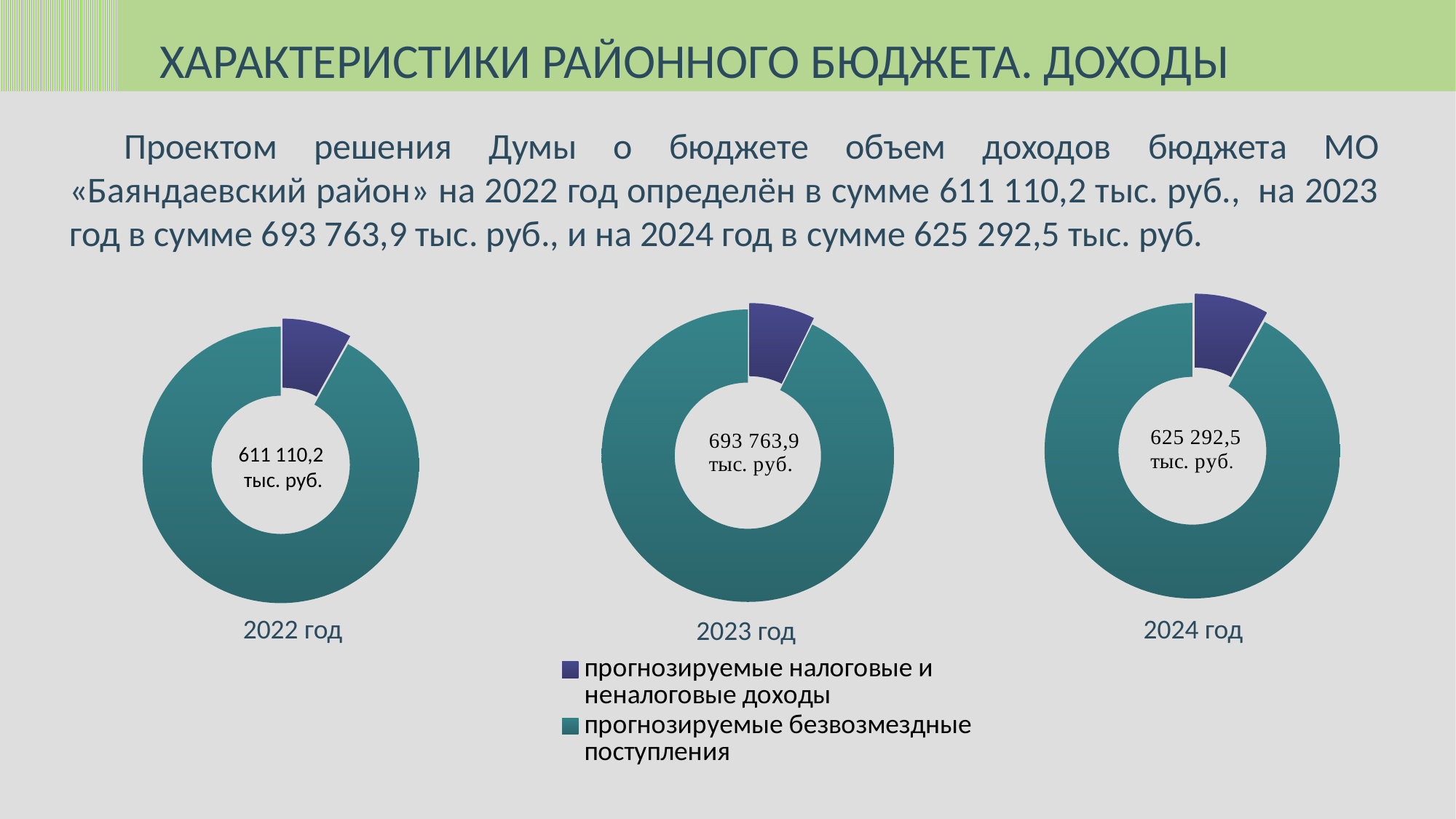
How many charts are shown on the slide? 3 In the 2022 год chart, what total value is printed in the centre? 611 110,2 тыс. руб. In the 2024 год chart, what total value is printed in the centre? 625 292,5 тыс. руб. Which year's chart shows the lowest total revenue in its centre? 2022 год In the 2023 год chart, what total value is printed in the centre? 693 763,9 тыс. руб. What is the title of the slide containing the charts? ХАРАКТЕРИСТИКИ РАЙОННОГО БЮДЖЕТА. ДОХОДЫ Which legend entry is shown in dark blue/purple? прогнозируемые налоговые и неналоговые доходы Which year's chart shows the highest total revenue in its centre? 2023 год In the 2024 год chart, which slice is larger: прогнозируемые налоговые и неналоговые доходы or прогнозируемые безвозмездные поступления? прогнозируемые безвозмездные поступления How many series does the legend list? 2 In the 2022 год chart, which slice is smaller: прогнозируемые налоговые и неналоговые доходы or прогнозируемые безвозмездные поступления? прогнозируемые налоговые и неналоговые доходы What kind of chart is used for the 2022 год chart? pie chart (donut)